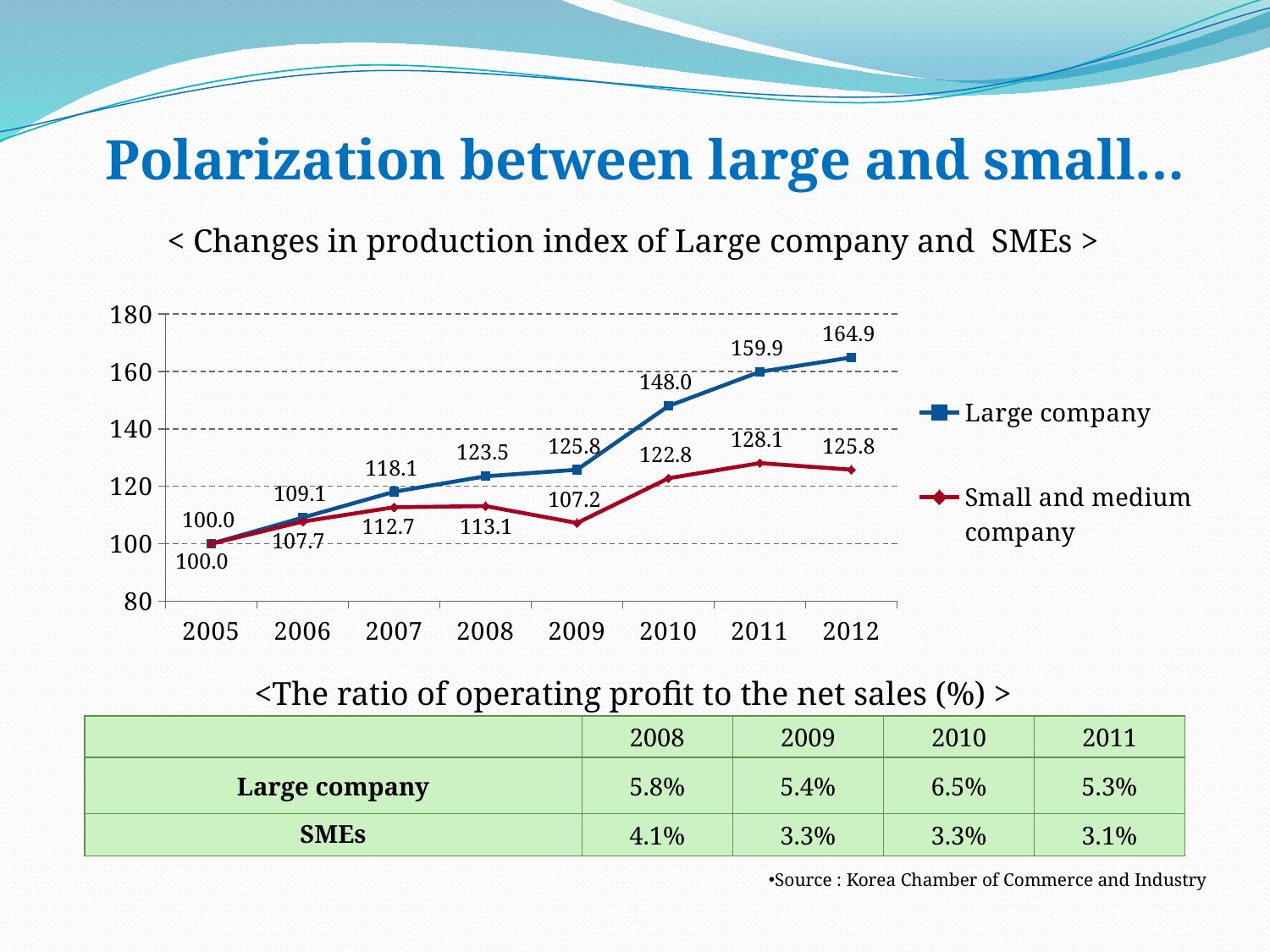
What is the production index value for Large company in 2012? 164.9 In which year does the Large company series have its lowest value? 2005 What type of chart is shown on the slide? Line chart What is the production index value for Large company in 2010? 148.0 Does the Large company series rise or fall from 2005 to 2012? Rise How many series does the chart legend list? 2 Which series has the larger value in 2011, Large company or Small and medium company? Large company In which year does the Small and medium company series reach its highest value? 2011 What colour is the line for Large company in the chart? Blue What is the difference between the Large company and Small and medium company values in 2012? 39.1 How many years are plotted on the x axis of the chart? 8 What is the production index value for Small and medium company in 2009? 107.2